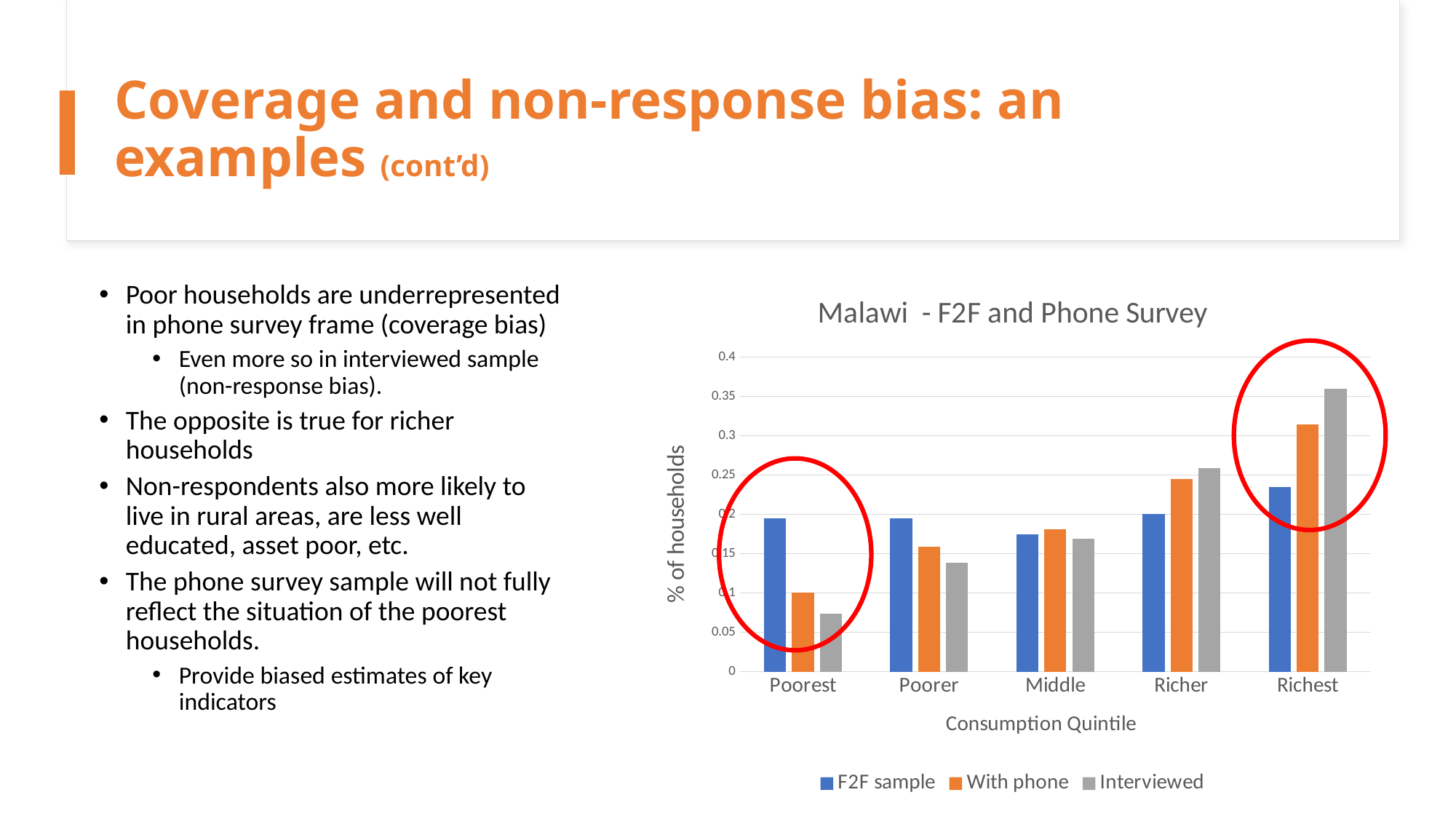
How many consumption quintile categories are shown on the x axis? 5 What is the title of the chart? Malawi - F2F and Phone Survey Is the With phone value for the Poorest quintile greater or less than 0.15? less Do the Interviewed values rise or fall moving from Poorest to Richest along the x axis? rise Is the F2F sample value for the Richer quintile greater or less than 0.25? less In the Richest quintile, which is larger: the With phone value or the F2F sample value? With phone Is the Interviewed value for the Richest quintile greater or less than 0.3? greater For the Interviewed series, which consumption quintile has the highest value? Richest How many series does the legend of the chart list? 3 For the Interviewed series, which consumption quintile has the lowest value? Poorest In the Poorest quintile, which is larger: the F2F sample value or the Interviewed value? F2F sample What kind of chart is shown on the slide? bar chart